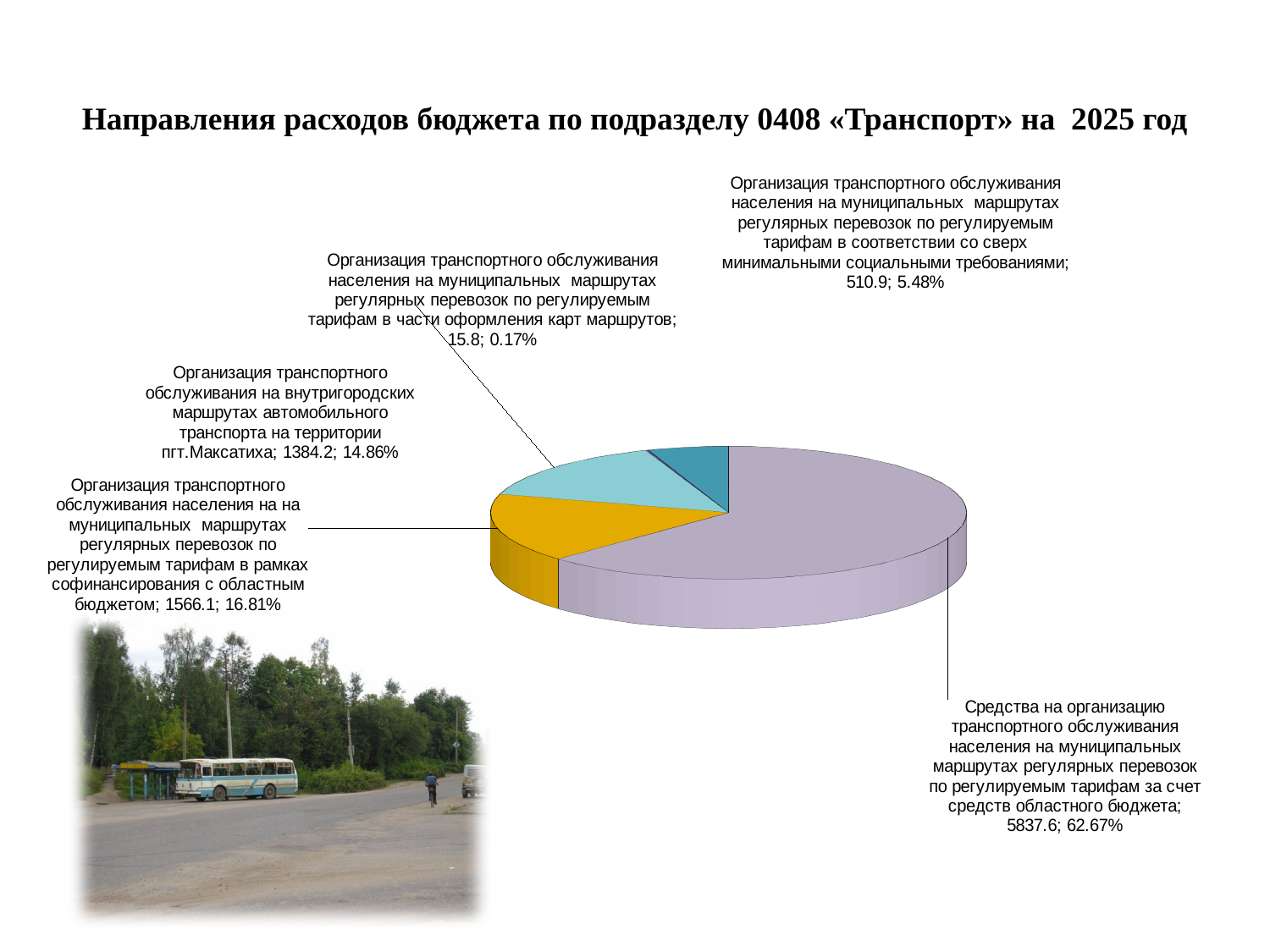
What is the value for 'Организация транспортного обслуживания на внутригородских маршрутах автомобильного транспорта на территории пгт.Максатиха'? 1384.2 What is the value for 'Организация транспортного обслуживания населения ... в части оформления карт маршрутов'? 15.8 What is the title of the chart on the slide? Направления расходов бюджета по подразделу 0408 «Транспорт» на 2025 год What share of the pie does 'Средства на организацию транспортного обслуживания ... за счет средств областного бюджета' represent? 62.67% What type of chart is shown on the slide? Pie chart What is the value for 'Средства на организацию транспортного обслуживания населения на муниципальных маршрутах регулярных перевозок по регулируемым тарифам за счет средств областного бюджета'? 5837.6 What is the value for 'Организация транспортного обслуживания населения ... в соответствии со сверх минимальными социальными требованиями'? 510.9 Which category has the smallest slice of the pie? Организация транспортного обслуживания населения на муниципальных маршрутах регулярных перевозок по регулируемым тарифам в части оформления карт маршрутов What percentage is shown for 'Организация транспортного обслуживания населения ... в рамках софинансирования с областным бюджетом'? 16.81% Which category has the largest slice of the pie? Средства на организацию транспортного обслуживания населения на муниципальных маршрутах регулярных перевозок по регулируемым тарифам за счет средств областного бюджета How many slices does the pie chart have? 5 What is the difference between the value for 'в рамках софинансирования с областным бюджетом' (1566.1) and the value for 'на территории пгт.Максатиха' (1384.2)? 181.9